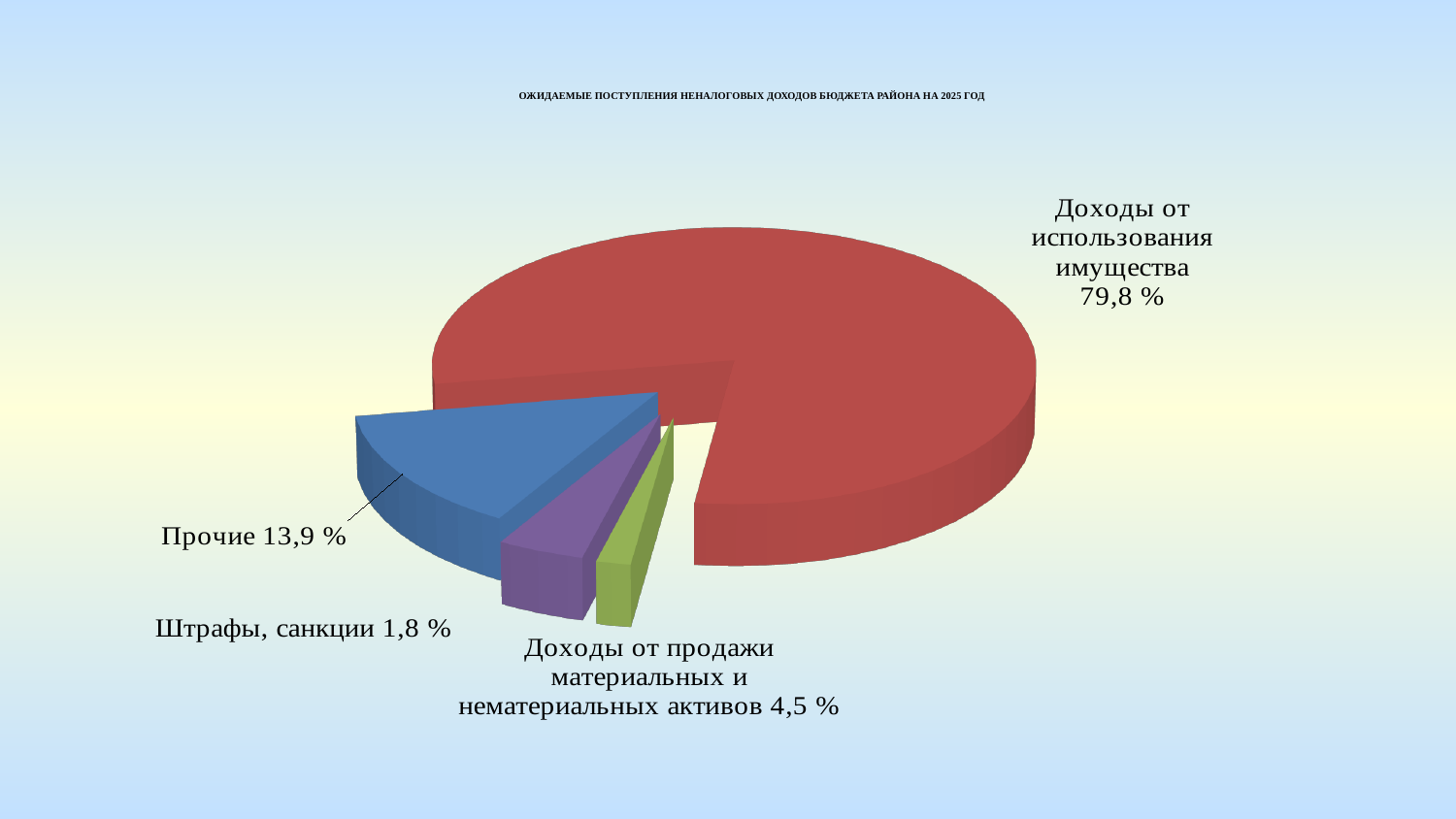
What share of the pie does Прочие represent? 13,9 % What type of chart is shown on the slide? Pie chart How many slices does the pie chart have? 4 Which is larger: the share for Прочие or the share for Доходы от продажи материальных и нематериальных активов? Прочие Which category has the largest share of the pie? Доходы от использования имущества What is the difference in percentage points between Доходы от использования имущества and Прочие? 65,9 What colour is the slice for Доходы от использования имущества? Red What share of the pie does Доходы от использования имущества represent? 79,8 % What is the title of the chart? ОЖИДАЕМЫЕ ПОСТУПЛЕНИЯ НЕНАЛОГОВЫХ ДОХОДОВ БЮДЖЕТА РАЙОНА НА 2025 ГОД Which category has the smallest share of the pie? Штрафы, санкции What share of the pie does Штрафы, санкции represent? 1,8 % What share of the pie does Доходы от продажи материальных и нематериальных активов represent? 4,5 %